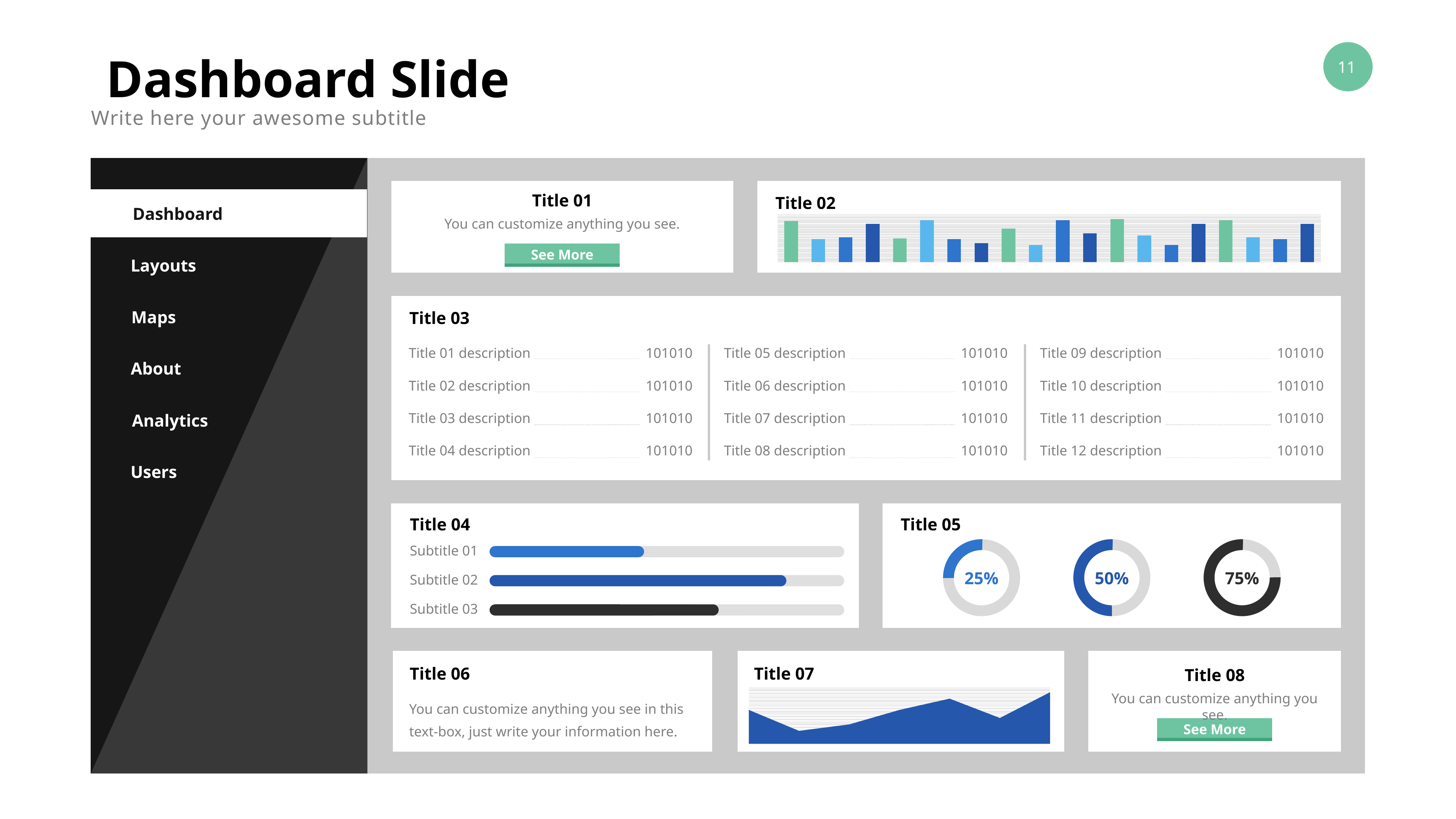
On the Title 05 chart, how many donut charts are shown? 3 On the Title 05 chart, what value is shown in the middle donut? 50% On the Title 05 chart, what colour is the ring of the 75% donut? black On the Title 05 chart, which donut shows the lowest percentage? 25% On the Title 05 chart, which donut shows the highest percentage? 75% What kind of chart is shown under Title 07? area chart On the Title 05 chart, what value is shown in the first (leftmost) donut? 25% On the Title 04 chart, which bar is longer, Subtitle 01 or Subtitle 02? Subtitle 02 On the Title 05 chart, what is the difference between the rightmost donut's value and the leftmost donut's value? 50% On the Title 05 chart, what value is shown in the rightmost donut? 75% On the Title 04 chart, how many progress bars are shown? 3 What kind of chart is shown under Title 02? bar chart